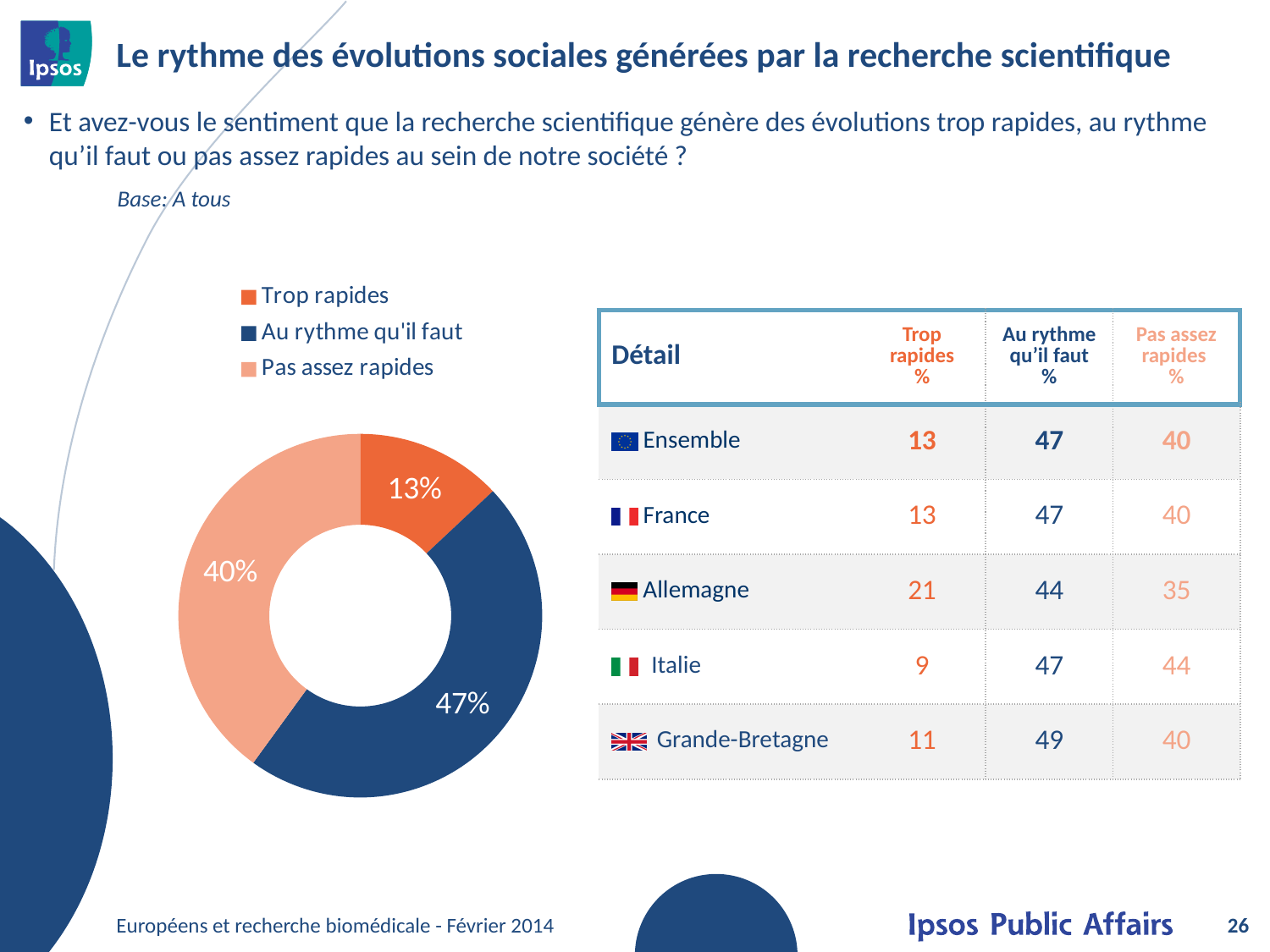
What percentage does the chart show for "Au rythme qu'il faut"? 47% What is the difference between the "Au rythme qu'il faut" and "Pas assez rapides" slices? 7% What percentage does the chart show for "Trop rapides"? 13% What percentage does the chart show for "Pas assez rapides"? 40% What is the difference between the "Pas assez rapides" and "Trop rapides" slices? 27% Which is larger in the chart, "Trop rapides" or "Pas assez rapides"? Pas assez rapides What kind of chart is shown on the slide? Donut (pie) chart Which category has the smallest slice in the chart? Trop rapides How many entries does the chart legend list? 3 Which category has the largest slice in the chart? Au rythme qu'il faut How many slices does the donut chart have? 3 What colour is the "Au rythme qu'il faut" slice in the chart? Dark blue